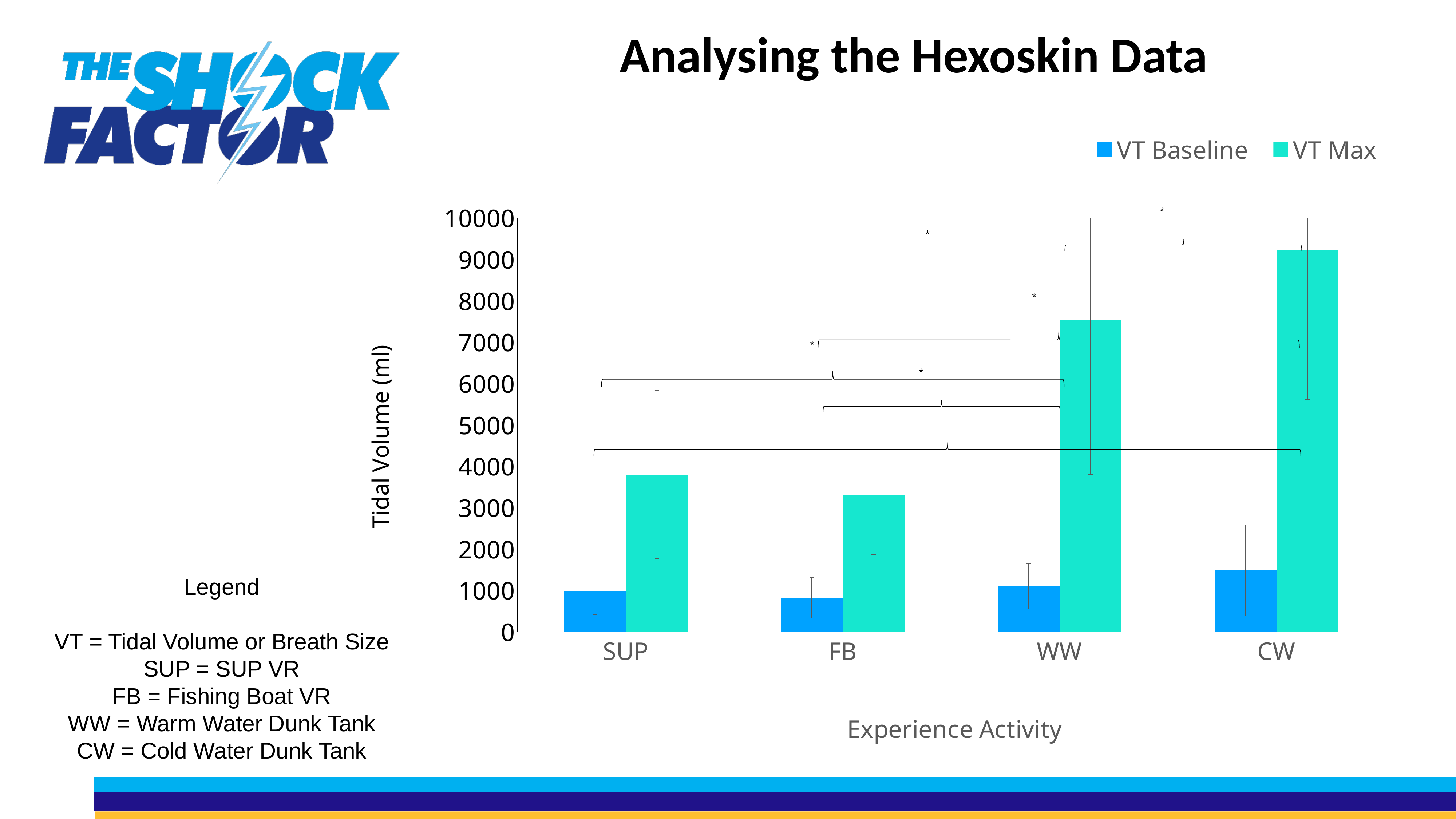
Which is larger, the VT Max value for WW or the VT Max value for SUP? WW Is the VT Max value for WW greater or less than 7000? greater What kind of chart is shown on the slide? bar chart Is the VT Max value for CW greater or less than 8000? greater How many series does the chart legend list? 2 Which experience activity has the highest VT Max value? CW Is the VT Baseline value for CW greater or less than 1000? greater What is the title of the y axis? Tidal Volume (ml) Which experience activity has the lowest VT Max value? FB How many experience activities are shown on the x axis? 4 Which experience activity has the highest VT Baseline value? CW